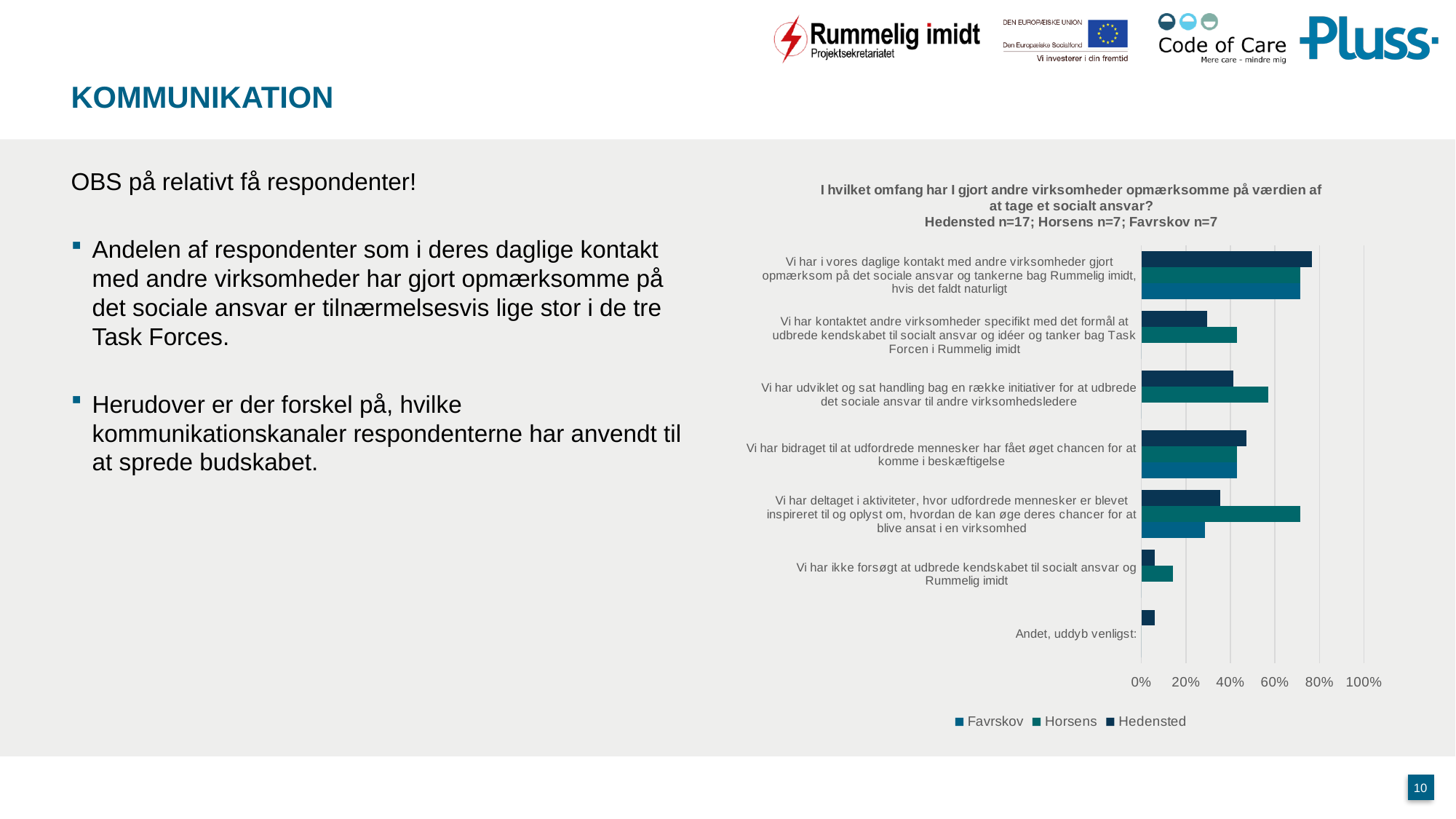
Is the Horsens value for 'Vi har ikke forsøgt at udbrede kendskabet til socialt ansvar og Rummelig imidt' greater or less than 20%? less How many series does the chart legend list? 3 What kind of chart is shown on the slide? Bar chart Is the Horsens value for 'Vi har deltaget i aktiviteter, hvor udfordrede mennesker er blevet inspireret til og oplyst om, hvordan de kan øge deres chancer for at blive ansat i en virksomhed' greater or less than 60%? greater Which series are listed in the chart legend? Favrskov, Horsens, Hedensted How many categories (statements) are shown on the chart's vertical axis? 7 Is the Hedensted value for 'Vi har kontaktet andre virksomheder specifikt med det formål at udbrede kendskabet til socialt ansvar og idéer og tanker bag Task Forcen i Rummelig imidt' greater or less than 40%? less For 'Vi har udviklet og sat handling bag en række initiativer for at udbrede det sociale ansvar til andre virksomhedsledere', which is larger: the Horsens value or the Hedensted value? Horsens What are the sample sizes stated in the chart title for Hedensted, Horsens and Favrskov? Hedensted n=17; Horsens n=7; Favrskov n=7 For 'Vi har deltaget i aktiviteter, hvor udfordrede mennesker er blevet inspireret til og oplyst om, hvordan de kan øge deres chancer for at blive ansat i en virksomhed', which is larger: the Horsens value or the Hedensted value? Horsens Which category has the highest value for Hedensted? Vi har i vores daglige kontakt med andre virksomheder gjort opmærksom på det sociale ansvar og tankerne bag Rummelig imidt, hvis det faldt naturligt